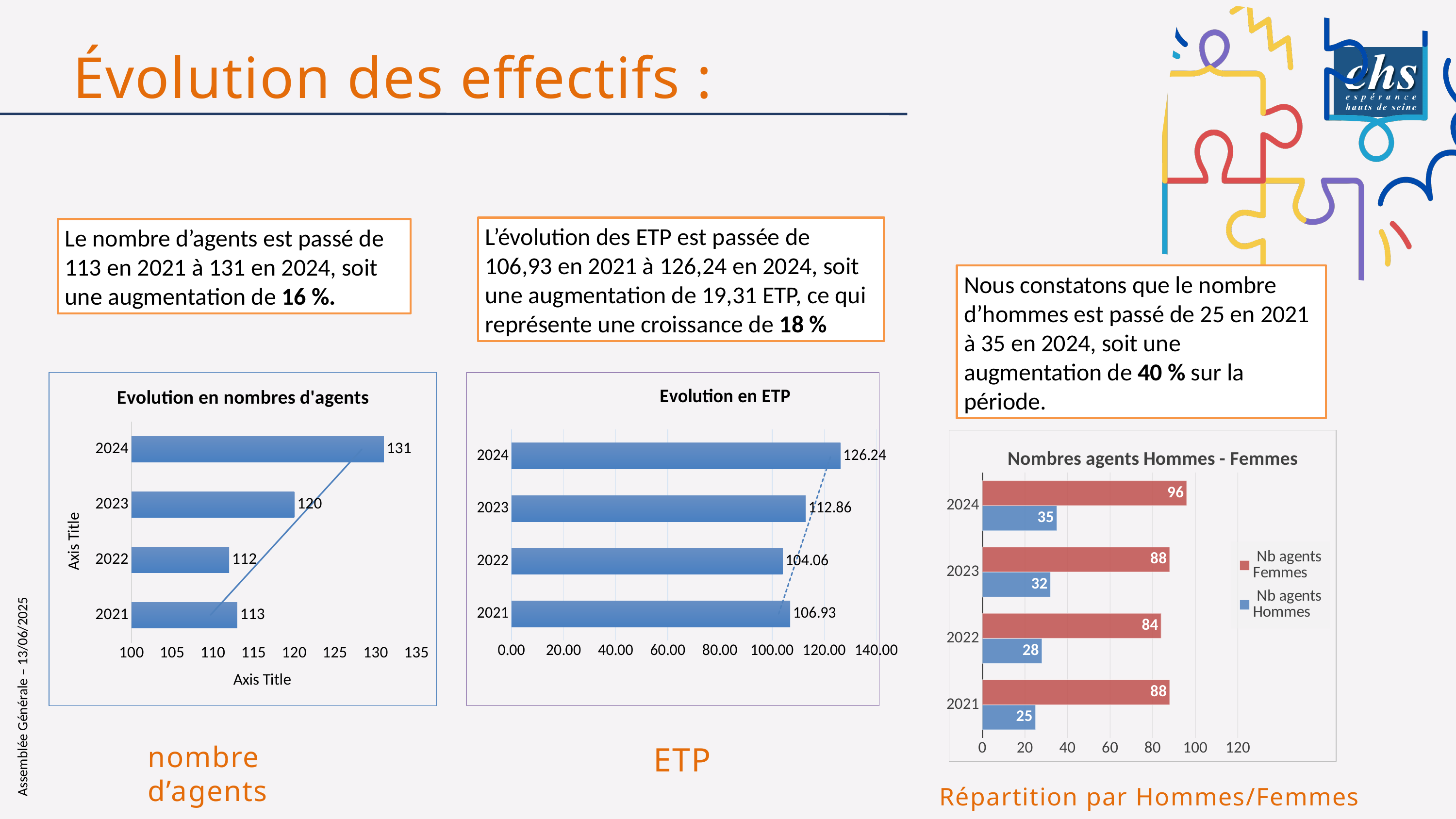
In the chart titled 'Nombres agents Hommes - Femmes', how many series does the legend list? 2 In the chart titled 'Evolution en nombres d'agents', what is the value for 2024? 131 In the chart titled 'Nombres agents Hommes - Femmes', what is the difference between Nb agents Femmes and Nb agents Hommes in 2024? 61 In the chart titled 'Evolution en ETP', which year has the highest value? 2024 In the chart titled 'Nombres agents Hommes - Femmes', what is the value for Nb agents Hommes in 2023? 32 In the chart titled 'Evolution en nombres d'agents', what is the difference between the values for 2024 and 2021? 18 In the chart titled 'Evolution en nombres d'agents', which year has the lowest value? 2022 In the chart titled 'Evolution en ETP', is the value for 2021 larger or smaller than the value for 2022? larger What kind of chart is the chart titled 'Nombres agents Hommes - Femmes'? bar chart In the chart titled 'Evolution en ETP', what is the value for 2023? 112.86 In the chart titled 'Nombres agents Hommes - Femmes', what is the value for Nb agents Femmes in 2022? 84 In the chart titled 'Evolution en ETP', how many years are plotted? 4